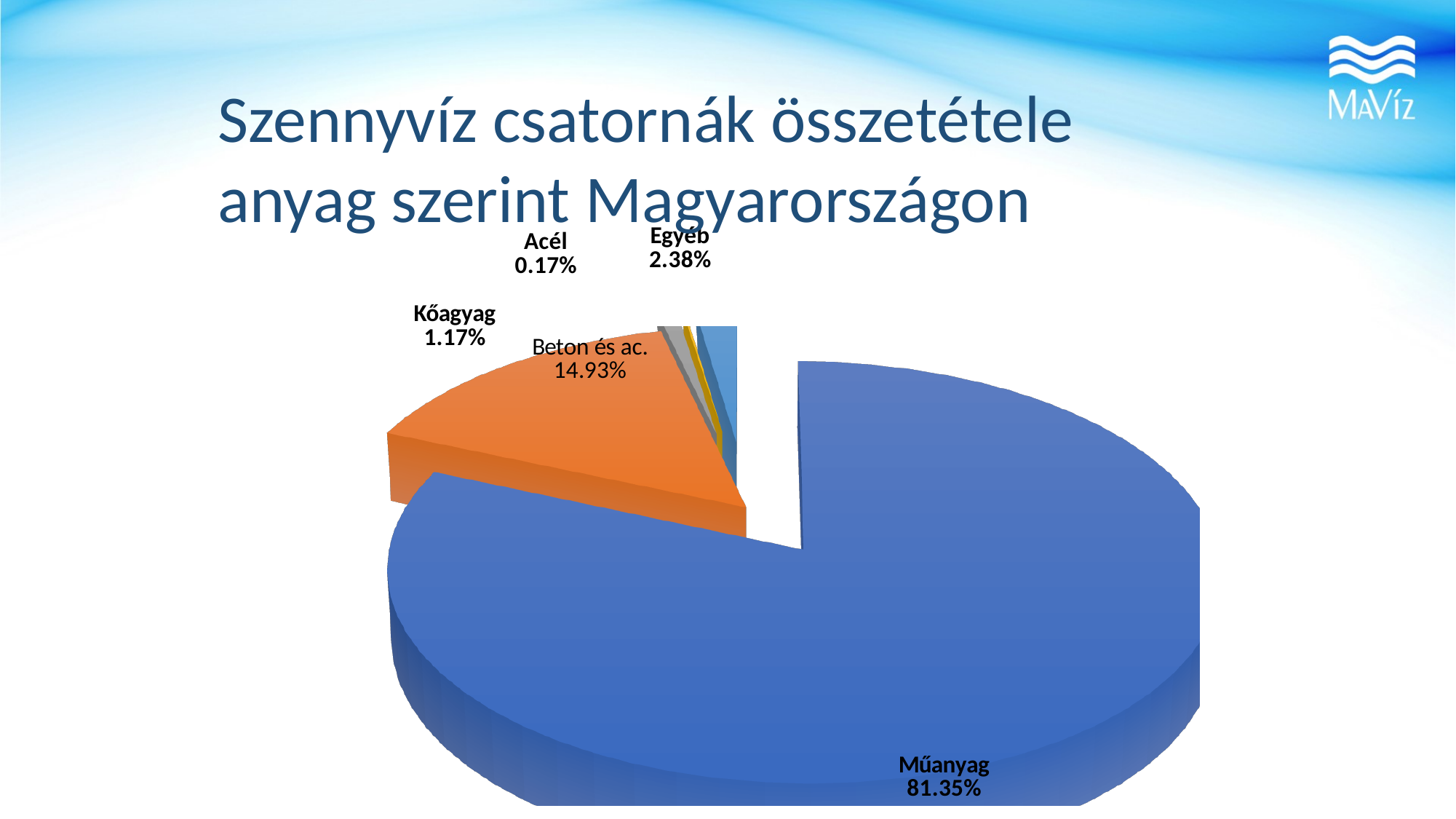
Which category has the smallest share of the pie? Acél What is the difference between the shares of Műanyag and Beton és ac.? 66.42% What is the share for Beton és ac.? 14.93% What is the title of the slide containing the chart? Szennyvíz csatornák összetétele anyag szerint Magyarországon How many categories are shown in the pie chart? 5 What kind of chart is shown on the slide? pie chart What is the share for Acél? 0.17% Which has a larger share, Egyéb or Kőagyag? Egyéb What is the share for Műanyag? 81.35% What is the share for Egyéb? 2.38% Which category has the largest share of the pie? Műanyag What is the share for Kőagyag? 1.17%